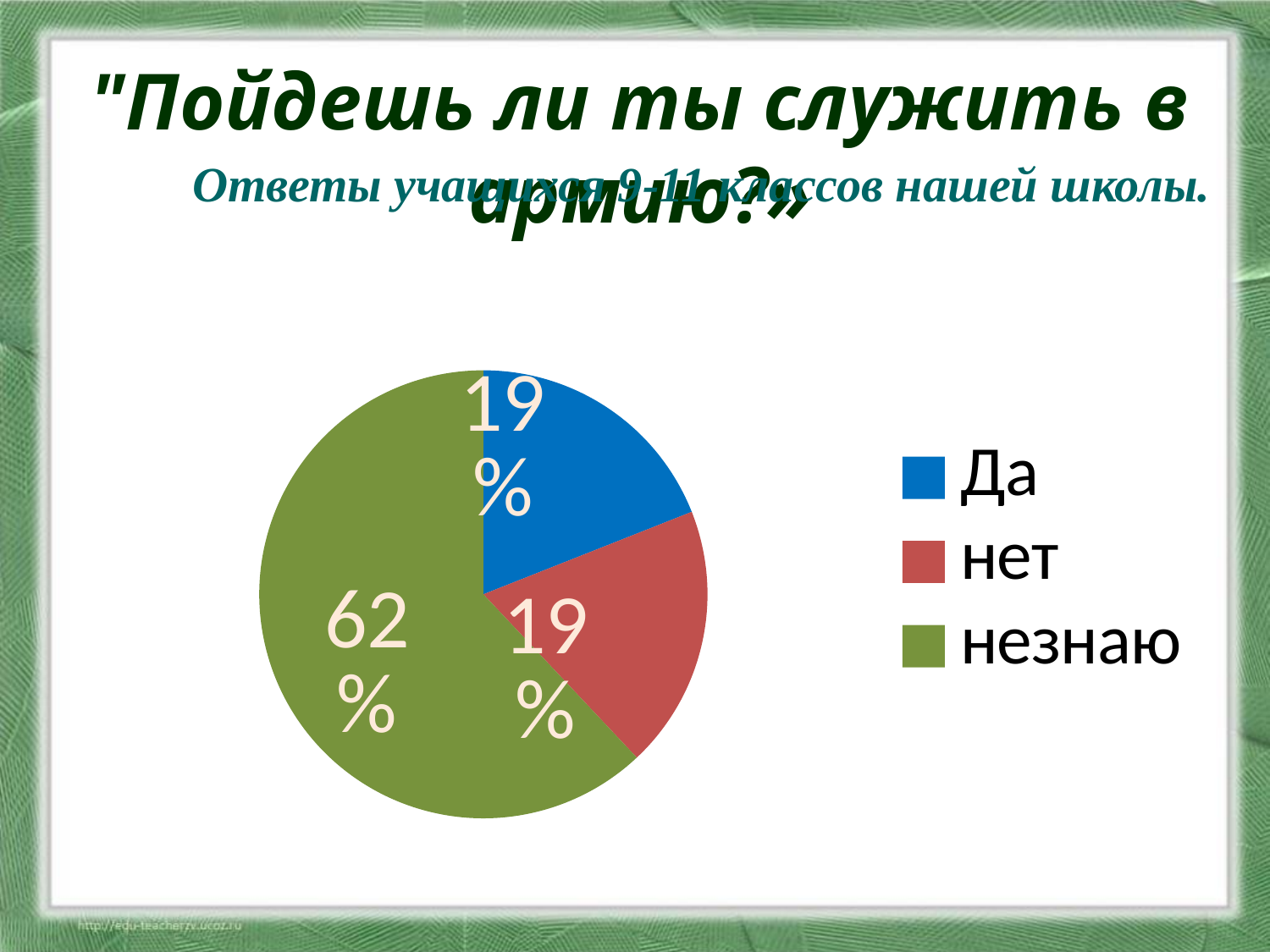
What percentage of respondents answered "незнаю"? 62% What is the difference in percentage points between "незнаю" and "Да"? 43 What percentage of respondents answered "Да"? 19% How many entries does the legend list? 3 Which answer has the largest share of the pie? незнаю How many slices does the pie chart have? 3 What kind of chart is shown on the slide? pie chart What colour is the "Да" slice? blue What percentage of respondents answered "нет"? 19% What colour is the "незнаю" slice? green What share of the pie does the "незнаю" slice take? 62% Which is larger, the share for "незнаю" or the share for "нет"? незнаю